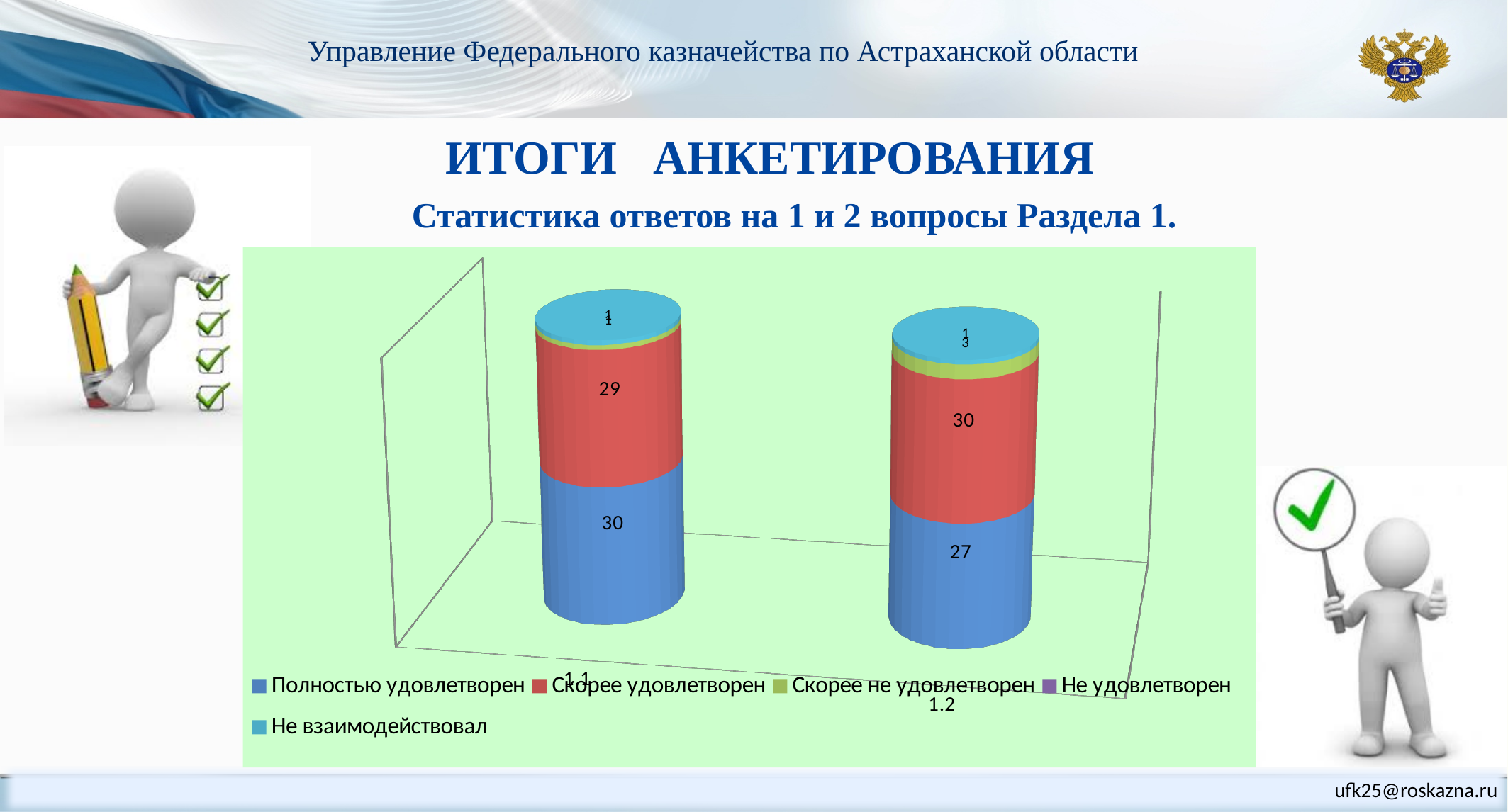
What is the difference between the Скорее удовлетворен values for 1.2 and 1.1? 1 What is the value of the Скорее удовлетворен segment for category 1.2? 30 Which category has the larger Полностью удовлетворен value, 1.1 or 1.2? 1.1 How many series does the chart legend list? 5 How many categories are shown on the x axis of the chart? 2 What is the value of the Полностью удовлетворен segment for category 1.1? 30 What type of chart is shown on the slide? Stacked bar chart What is the value of the Скорее не удовлетворен segment for category 1.2? 3 What is the value of the Полностью удовлетворен segment for category 1.2? 27 What is the difference between the Полностью удовлетворен values for 1.1 and 1.2? 3 What is the value of the Скорее удовлетворен segment for category 1.1? 29 Within category 1.2, which is larger: the Полностью удовлетворен segment or the Скорее удовлетворен segment? Скорее удовлетворен